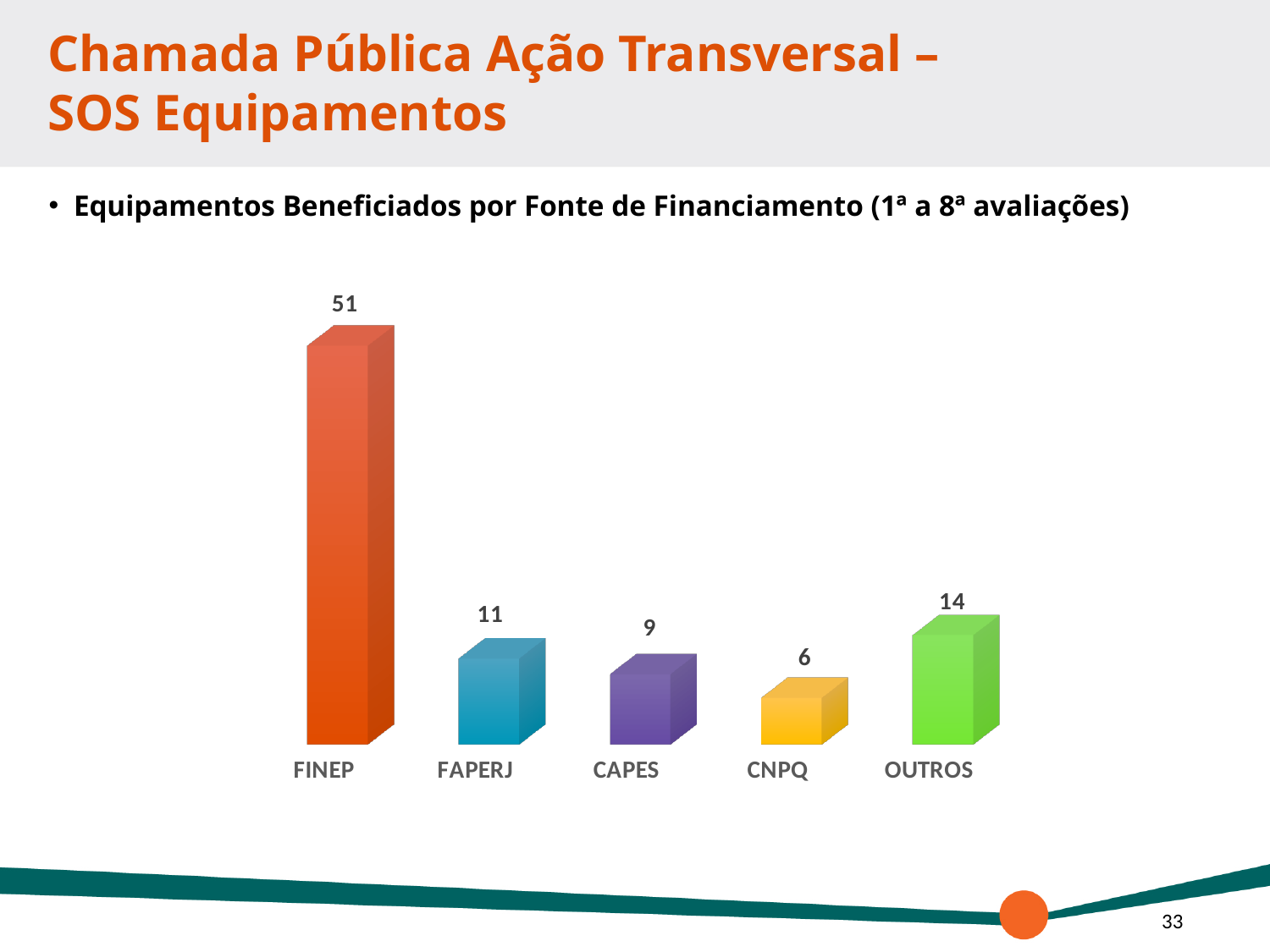
Which category has the highest value? FINEP What is the value for OUTROS? 14 What is the difference between the values for FINEP and OUTROS? 37 What kind of chart is shown on the slide? Bar chart What is the value for CAPES? 9 Which is larger, the value for OUTROS or the value for FAPERJ? OUTROS What is the difference between the values for FAPERJ and CAPES? 2 What is the value for CNPQ? 6 Which category has the lowest value? CNPQ What is the value for FAPERJ? 11 What is the value for FINEP? 51 How many categories are shown in the chart? 5